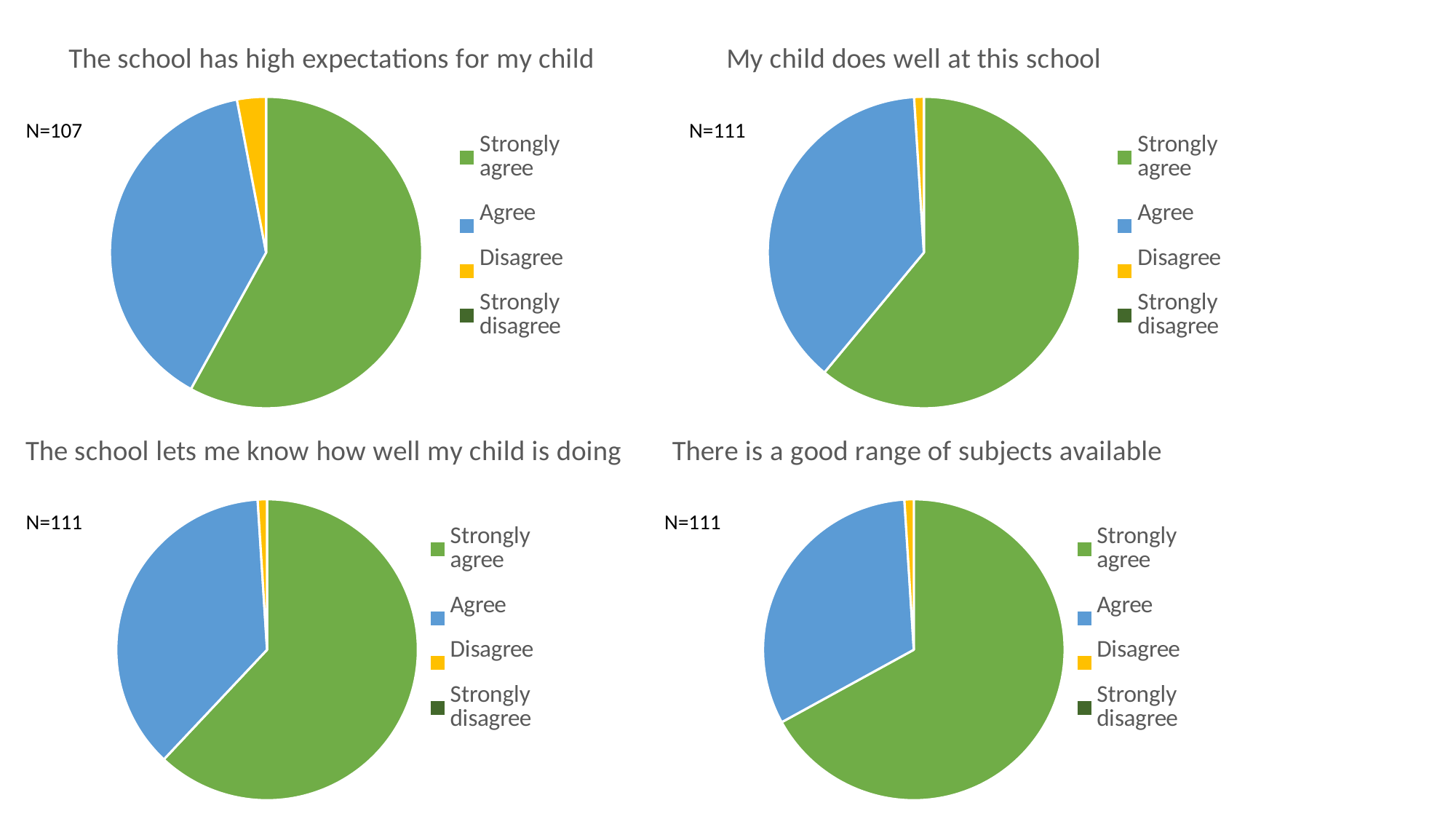
In the chart "My child does well at this school", which slice is larger: Agree or Disagree? Agree In the chart "The school lets me know how well my child is doing", which slice is larger: Strongly agree or Agree? Strongly agree In the chart "The school lets me know how well my child is doing", which response is shown in yellow? Disagree What kind of chart is used for "The school has high expectations for my child"? Pie chart How many charts are shown on the slide? 4 What is the N value shown for the chart "There is a good range of subjects available"? N=111 In the chart "My child does well at this school", how many categories does the legend list? 4 In the chart "There is a good range of subjects available", which response has the largest slice? Strongly agree What is the N value shown for the chart "The school has high expectations for my child"? N=107 In the chart "The school has high expectations for my child", which response has the largest slice? Strongly agree In the chart "The school has high expectations for my child", which slice is smaller: Agree or Disagree? Disagree